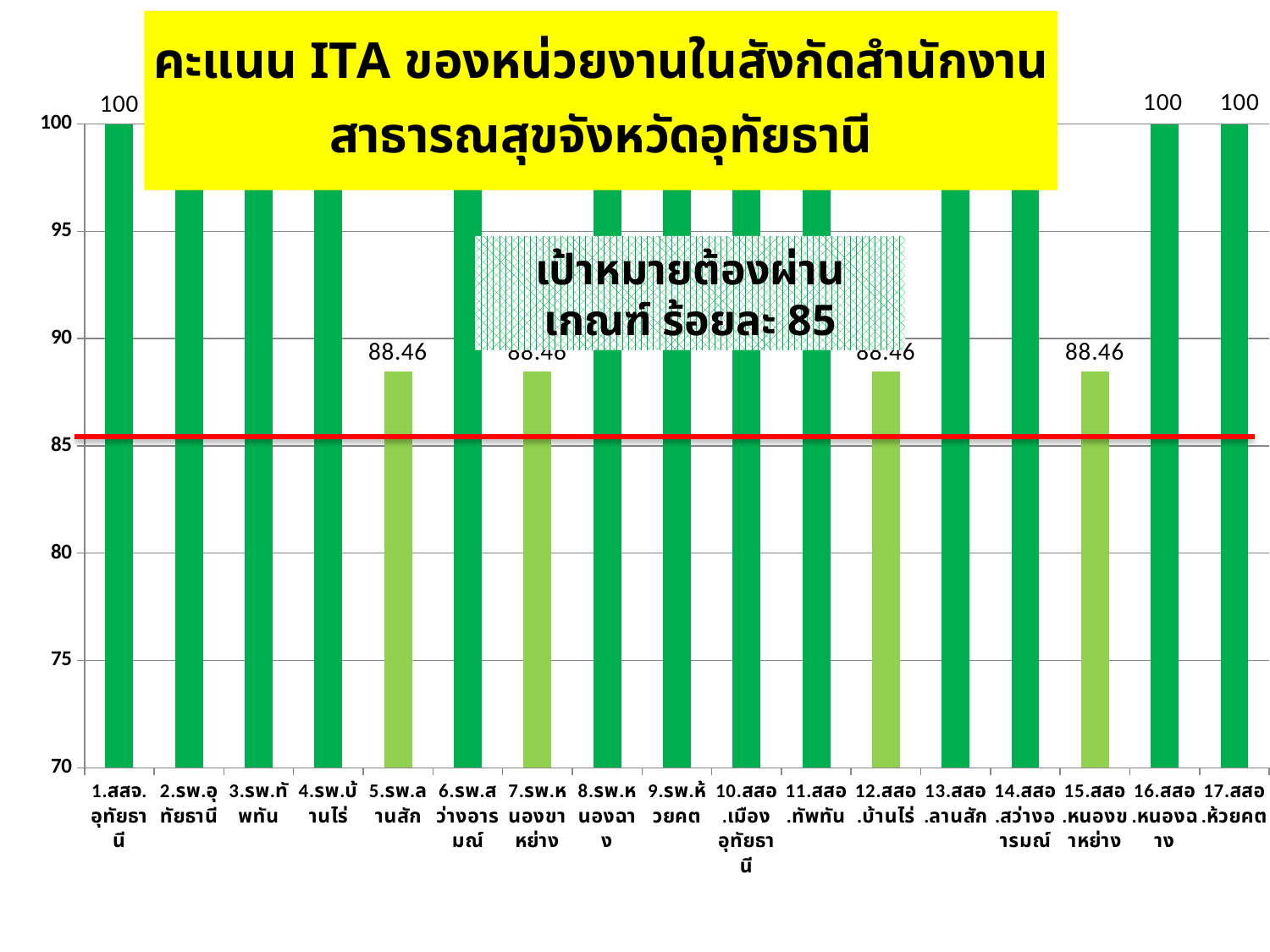
What kind of chart is shown on the slide? bar chart What is the ITA score for 17.สสอ.ห้วยคต? 100 How many units (categories) are shown on the x axis of the chart? 17 Which has the higher ITA score, 1.สสจ.อุทัยธานี or 5.รพ.ลานสัก? 1.สสจ.อุทัยธานี How many bars in the chart fall below 90? 4 Is the value for 5.รพ.ลานสัก greater or less than 90? less What is the difference between the ITA score of 16.สสอ.หนองฉาง and that of 15.สสอ.หนองขาหย่าง? 11.54 What is the ITA score for 15.สสอ.หนองขาหย่าง? 88.46 What is the ITA score for 5.รพ.ลานสัก? 88.46 What is the ITA score for 1.สสจ.อุทัยธานี? 100 Is the value for 3.รพ.ทัพทัน greater or less than 95? greater According to the text box on the chart, what percentage is the target threshold that units must pass? 85